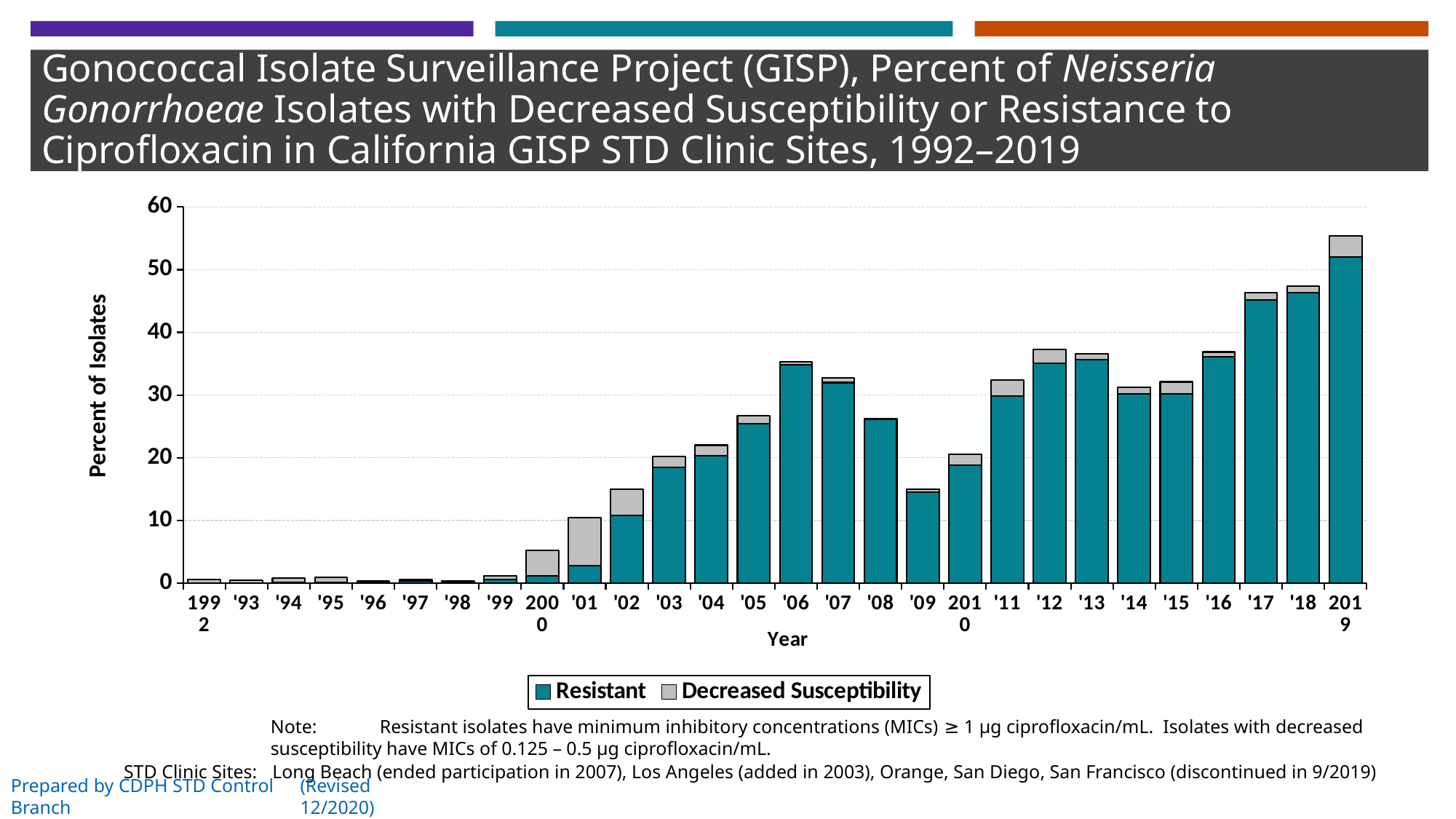
What colour represents the Resistant series? Teal How many years are plotted along the x axis? 28 Overall, do the values rise or fall from 1992 to 2019? Rise How many series does the legend list? 2 Which year has the largest Decreased Susceptibility segment? 2001 Which year has the highest total percent of isolates? 2019 Is the total value for 2009 greater or less than 20? less Is the total value for 2017 greater or less than 40? greater What kind of chart is shown on the slide? Stacked bar chart Is the total value for 2000 greater or less than 10? less Which year has the larger total, 2006 or 2007? 2006